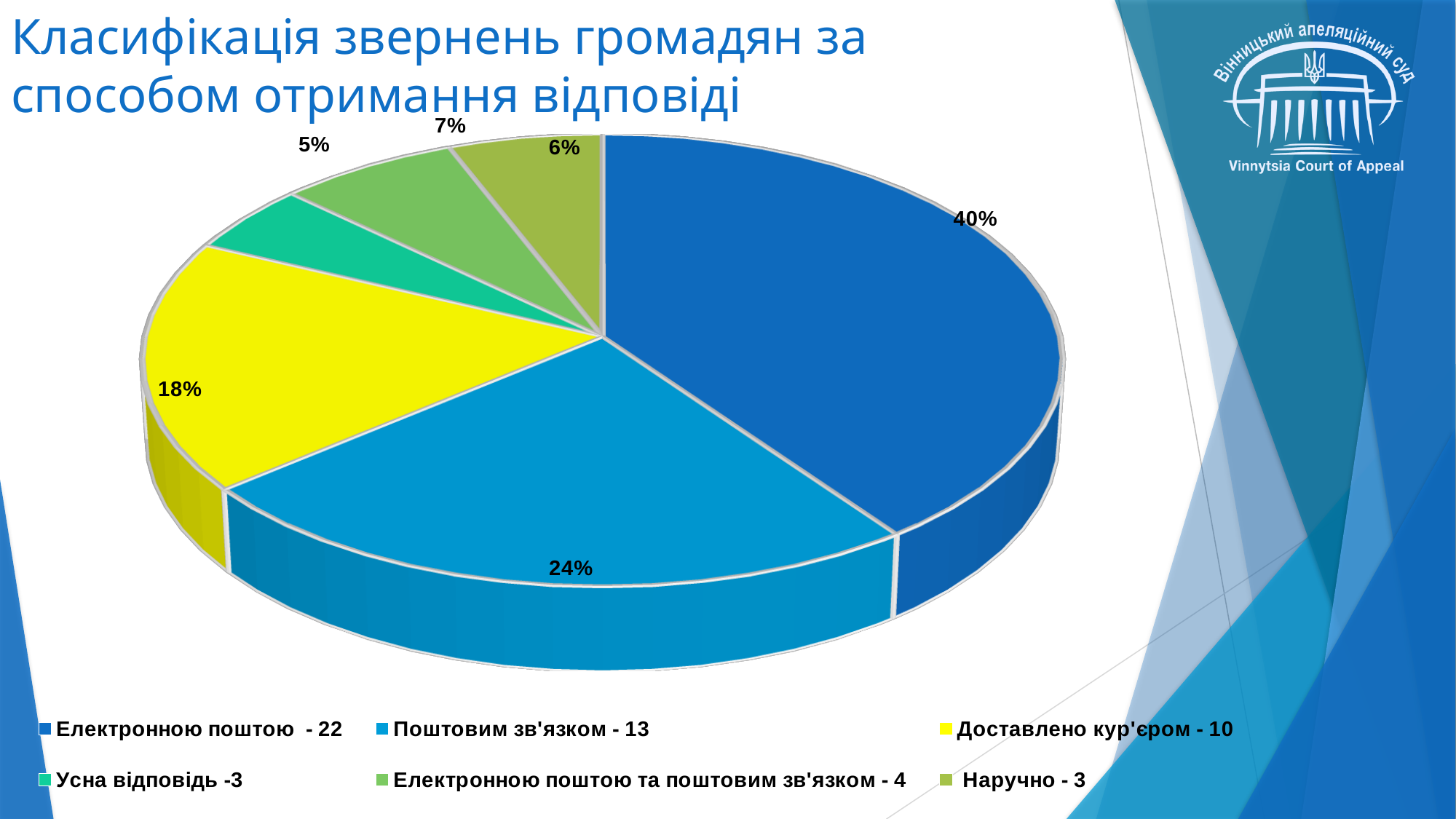
What percentage share is shown for the slice 'Електронною поштою'? 40% What is the title of the chart on the slide? Класифікація звернень громадян за способом отримання відповіді What is the difference in percentage points between the 'Електронною поштою' slice and the 'Поштовим зв'язком' slice? 16% What type of chart is shown on the slide? Pie chart What percentage share is shown for the slice 'Поштовим зв'язком'? 24% Which category has the smallest share of the pie? Усна відповідь What percentage share is shown for the slice 'Усна відповідь'? 5% Which category has the largest share of the pie? Електронною поштою Which is larger: the share for 'Наручно' or the share for 'Усна відповідь'? Наручно How many slices does the pie chart have? 6